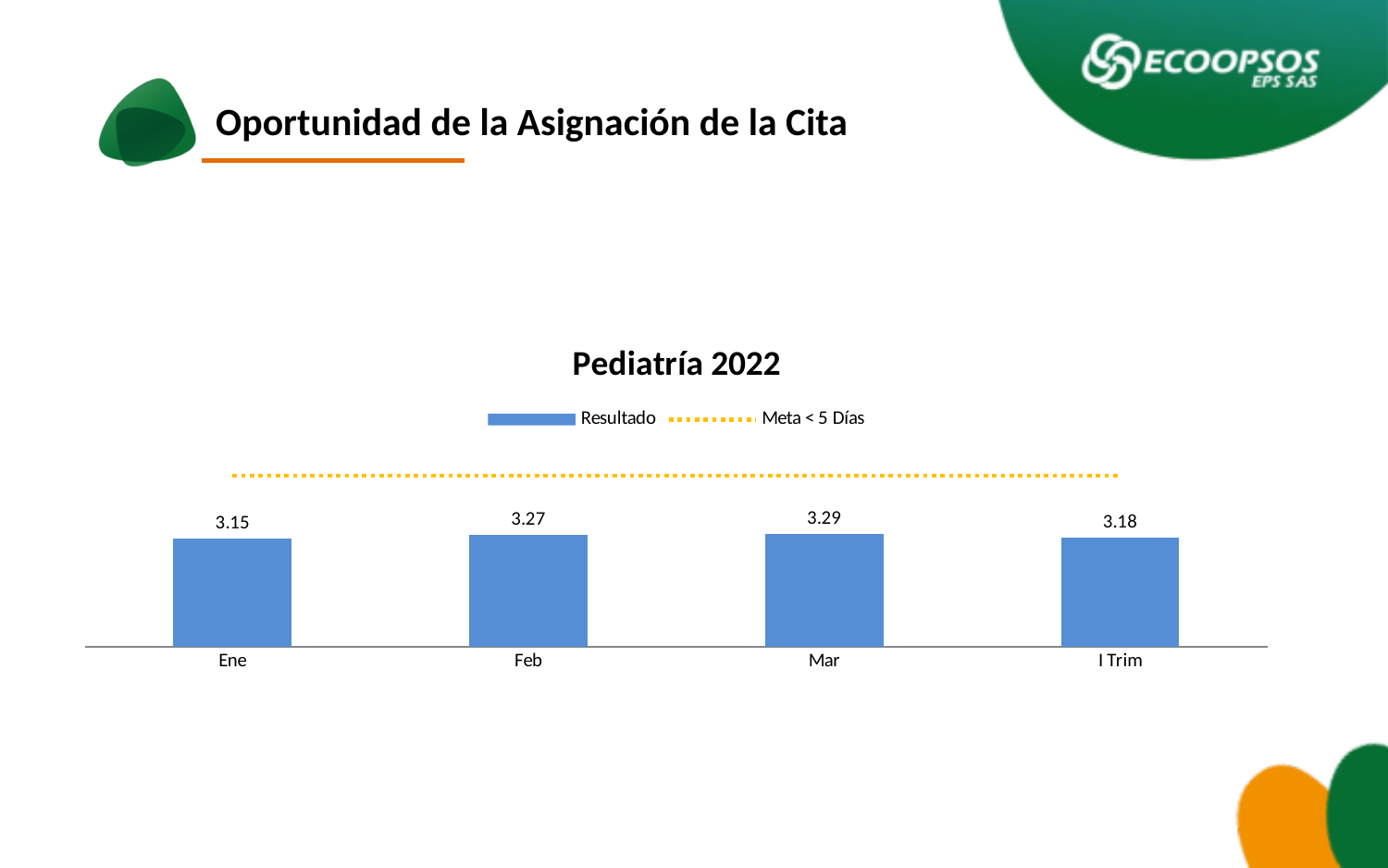
What kind of chart is shown on the slide? Combination bar and line chart What is the Resultado value for I Trim? 3.18 What is the title of the chart? Pediatría 2022 What is the difference between the Resultado values for Feb and Ene? 0.12 Which has a larger Resultado value, Feb or I Trim? Feb How many categories are shown on the x axis? 4 What is the name of the series shown as a dotted line in the legend? Meta < 5 Días How many series does the legend list? 2 Which category has the highest Resultado value? Mar What is the Resultado value for Mar? 3.29 Which category has the lowest Resultado value? Ene What is the Resultado value for Ene? 3.15